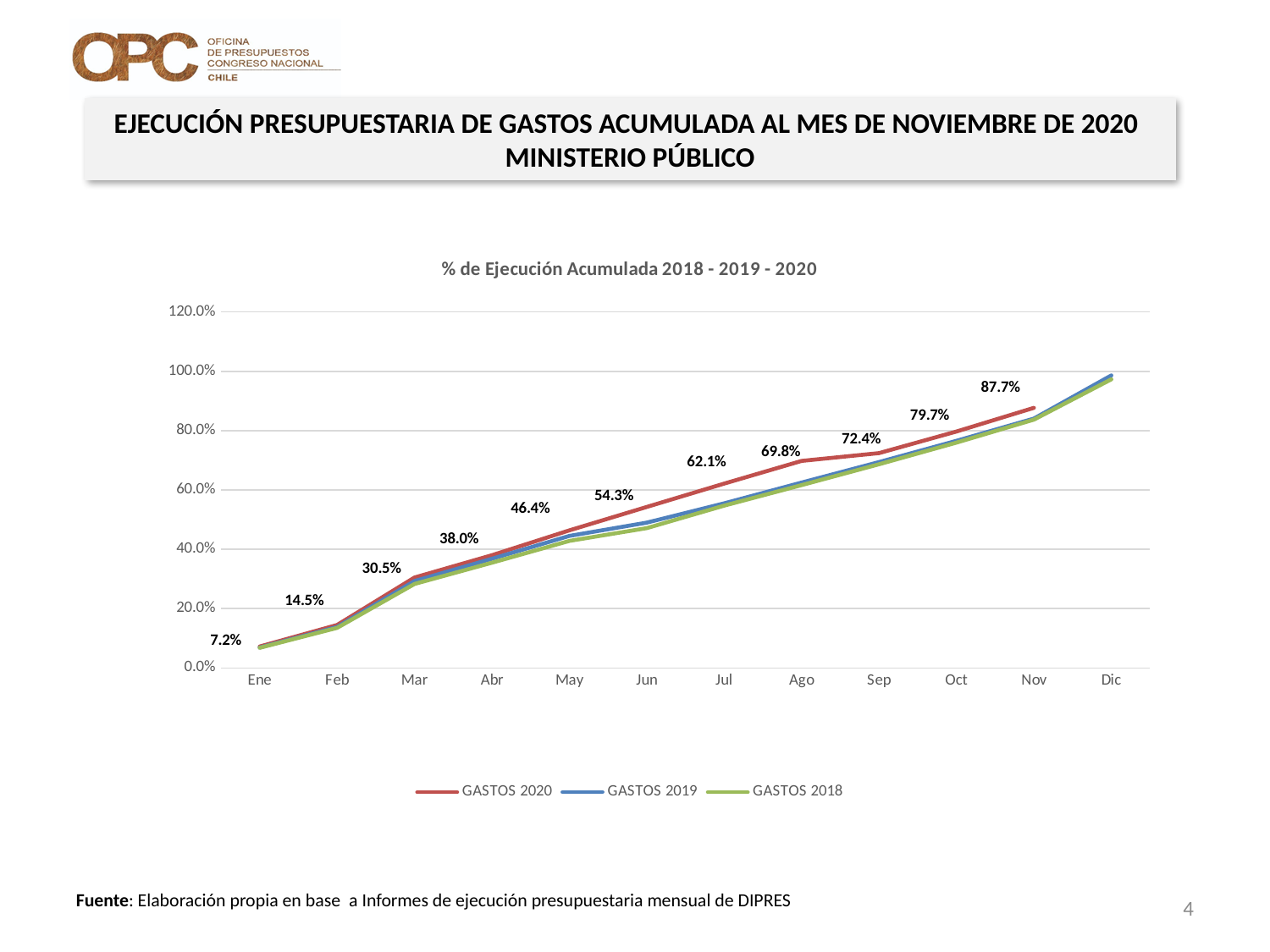
How many series does the legend list? 3 What is the difference between the GASTOS 2020 values for Nov and Oct? 8.0% Is the value for GASTOS 2019 in Dic greater or less than 80.0%? greater What type of chart is shown on the slide? line chart What is the value for GASTOS 2020 in Nov? 87.7% Do the GASTOS 2020 values rise or fall from Ene to Nov? rise What is the difference between the GASTOS 2020 values for Mar and Feb? 16.0% What is the value for GASTOS 2020 in Jun? 54.3% Which series is drawn in red? GASTOS 2020 What is the value for GASTOS 2020 in Ene? 7.2% What is the title of the chart? % de Ejecución Acumulada 2018 - 2019 - 2020 How many months are shown on the x axis? 12